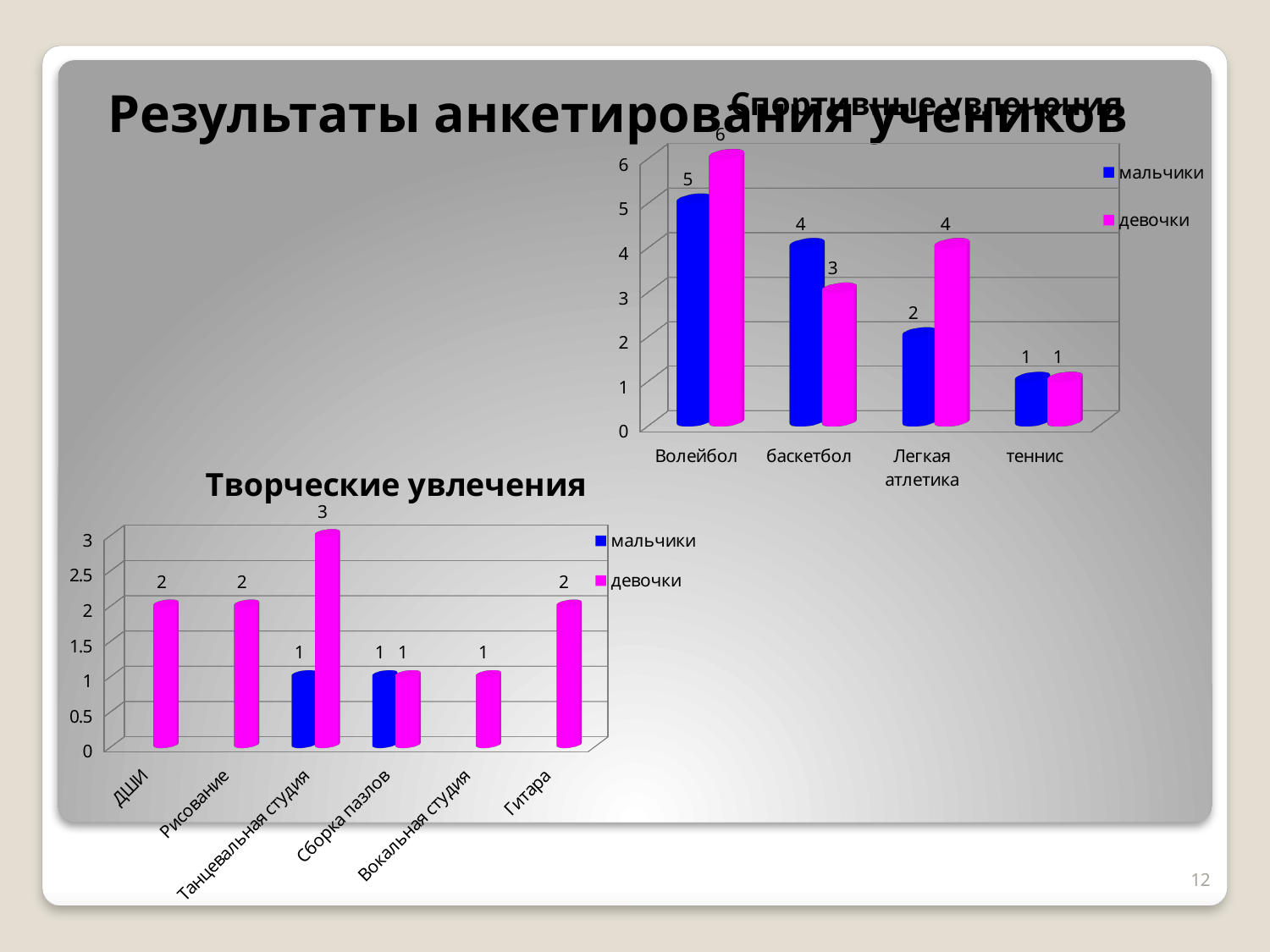
In the bottom-left chart (Творческие увлечения), what is the value for девочки for Гитара? 2 How many series does the legend of the bottom-left chart (Творческие увлечения) list? 2 In the bottom-left chart (Творческие увлечения), what is the value for девочки for Танцевальная студия? 3 In the top-right chart (Спортивные увлечения), what is the value for девочки for Волейбол? 6 In the top-right chart (Спортивные увлечения), what is the value for мальчики for баскетбол? 4 In the top-right chart (Спортивные увлечения), which category has the highest value for мальчики? Волейбол What kind of chart is the bottom-left chart (Творческие увлечения)? bar chart In the top-right chart (Спортивные увлечения), how many categories are shown on the x axis? 4 In the bottom-left chart (Творческие увлечения), which category has the highest value for девочки? Танцевальная студия In the bottom-left chart (Творческие увлечения), how many categories are shown on the x axis? 6 In the top-right chart (Спортивные увлечения), which is larger for баскетбол: мальчики or девочки? мальчики In the top-right chart (Спортивные увлечения), what is the difference between девочки and мальчики for Легкая атлетика? 2